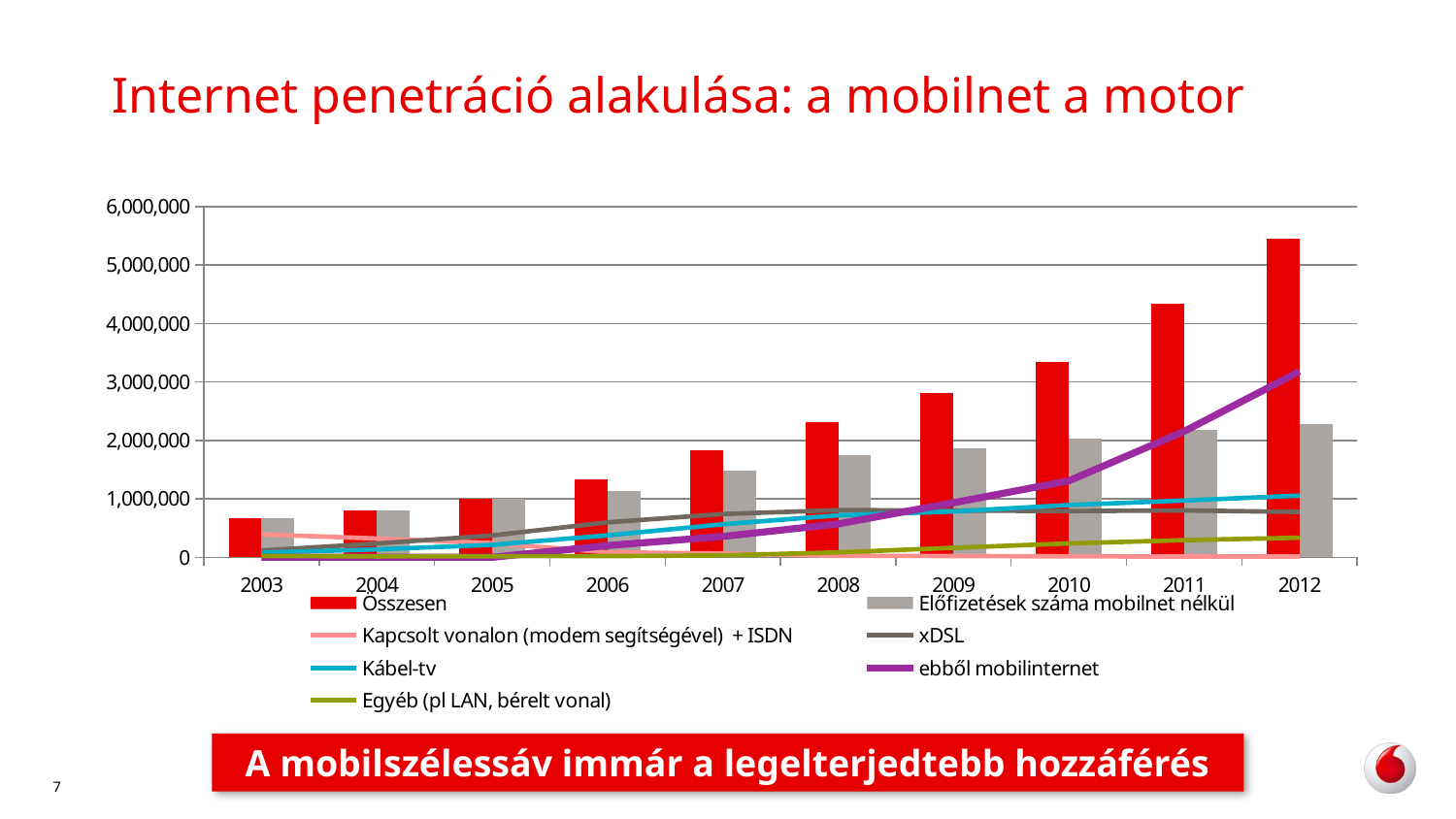
How many years are shown on the x axis of the chart? 10 What is the title of the slide's chart? Internet penetráció alakulása: a mobilnet a motor Does the Összesen series rise or fall from 2003 to 2012? rise How many series does the chart's legend list? 7 Is the Összesen value for 2009 greater or less than 3,000,000? less What colour are the Összesen bars in the chart? Red Is the Előfizetések száma mobilnet nélkül value for 2012 greater or less than 2,000,000? greater Is the Összesen value for 2012 greater or less than 5,000,000? greater In 2012, which is larger: Összesen or Előfizetések száma mobilnet nélkül? Összesen In which year is the Összesen bar the lowest? 2003 What kind of chart is shown on the slide? A combination bar and line chart In which year is the Összesen bar the highest? 2012